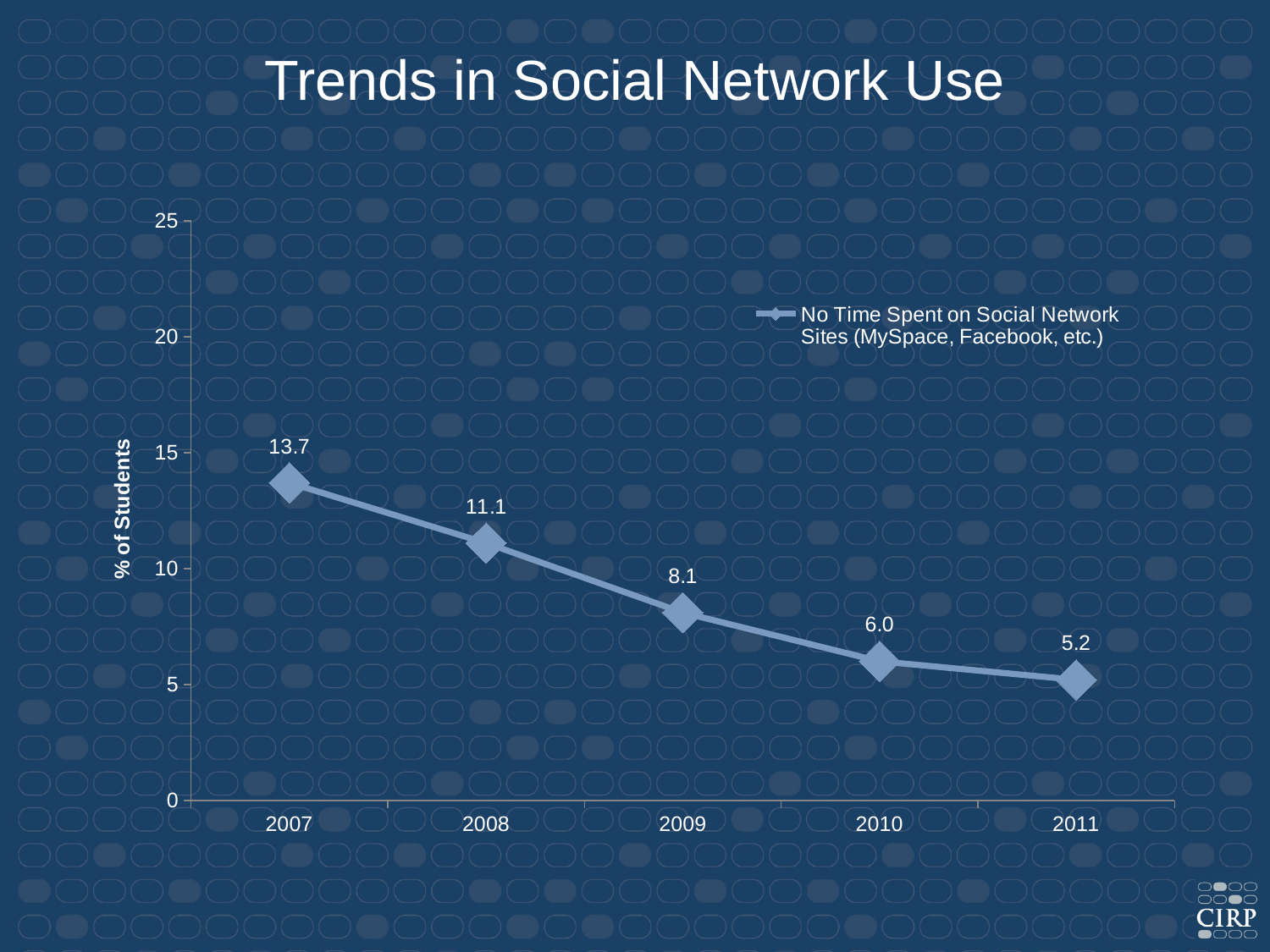
Which year has the lowest value? 2011 What is the value for 2007? 13.7 What kind of chart is shown on the slide? Line chart What is the difference between the values for 2008 and 2009? 3.0 How many years are plotted on the chart? 5 Which is larger, the value for 2008 or the value for 2010? 2008 Do the values rise or fall from 2007 to 2011? Fall What is the value for 2009? 8.1 How many series does the legend list? 1 Which year has the highest value? 2007 What is the value for 2011? 5.2 What is the difference between the values for 2007 and 2011? 8.5